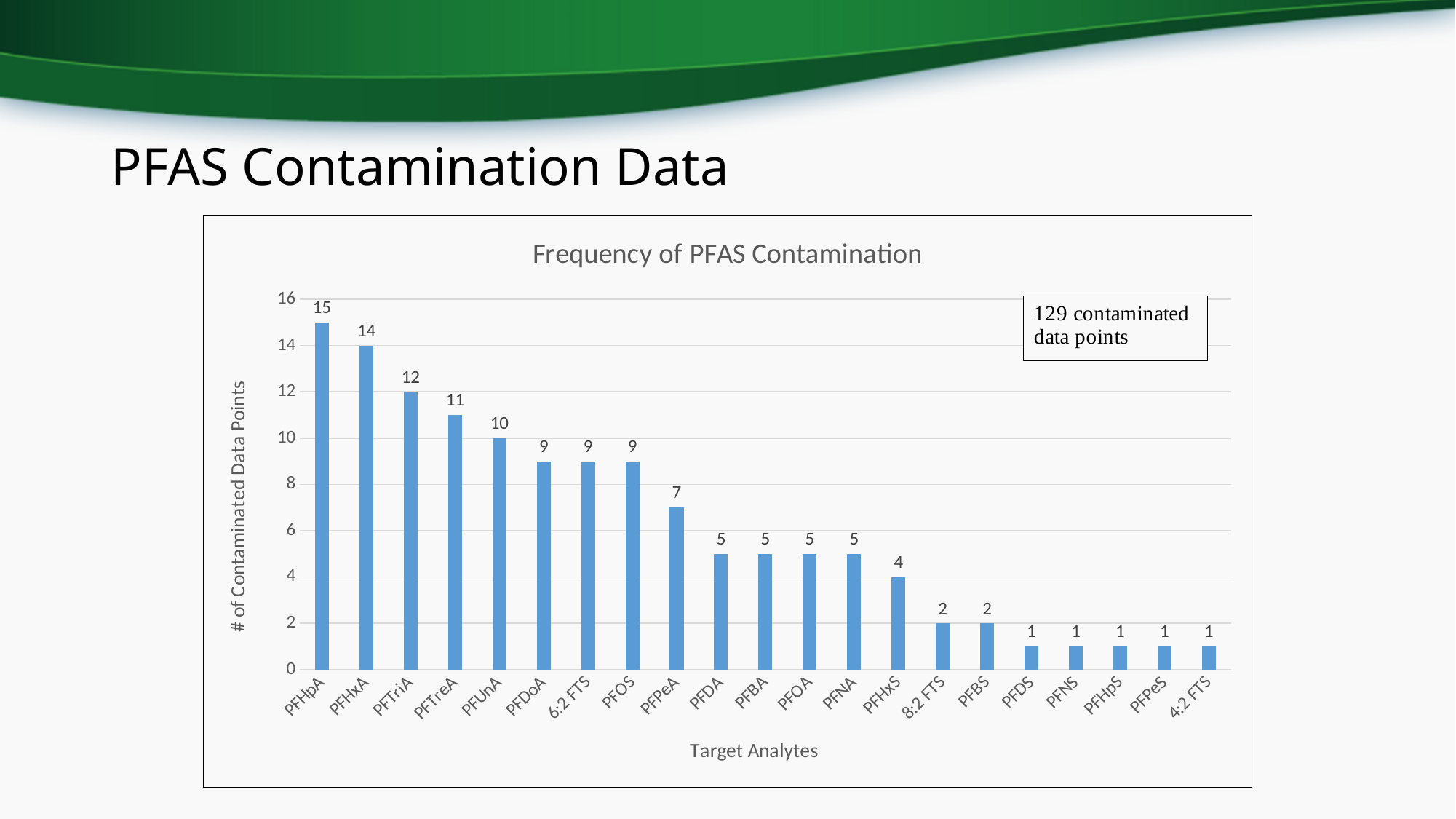
What is the difference between the values for PFHpA and PFHxA? 1 How many contaminated data points are shown for PFOS? 9 Which target analyte has the highest number of contaminated data points? PFHpA What is the difference between the values for PFTriA and PFPeA? 5 Do the values rise or fall moving left to right along the x axis? Fall Which has a larger value, PFBS or PFDS? PFBS What is the title of the chart? Frequency of PFAS Contamination Which has a larger value, PFUnA or PFDoA? PFUnA How many target analytes are shown on the x axis? 21 What is the value for PFHpA? 15 What kind of chart is shown on the slide? Bar chart What is the value for PFHxS? 4